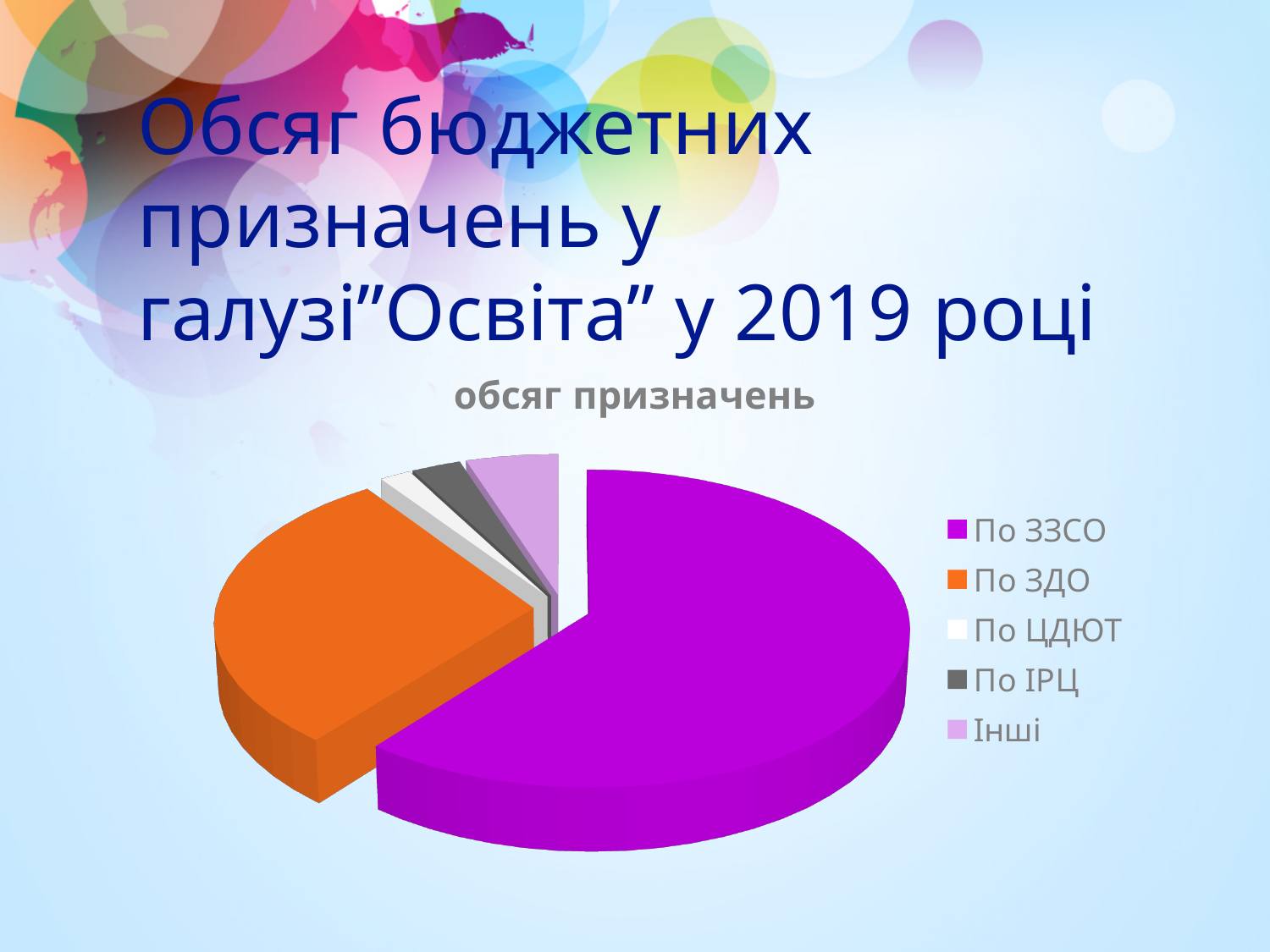
Which slice is larger, По ЗЗСО or По ЗДО? По ЗЗСО How many categories does the pie chart show? 5 Which slice is larger, По ЗДО or Інші? По ЗДО What is the title of the chart? обсяг призначень Which category has the largest slice of the pie chart? По ЗЗСО How many entries does the legend list? 5 Which category is shown in orange in the pie chart? По ЗДО Which category has the second-largest slice of the pie chart? По ЗДО What kind of chart is shown on the slide? pie chart Which slice is larger, Інші or По ІРЦ? Інші